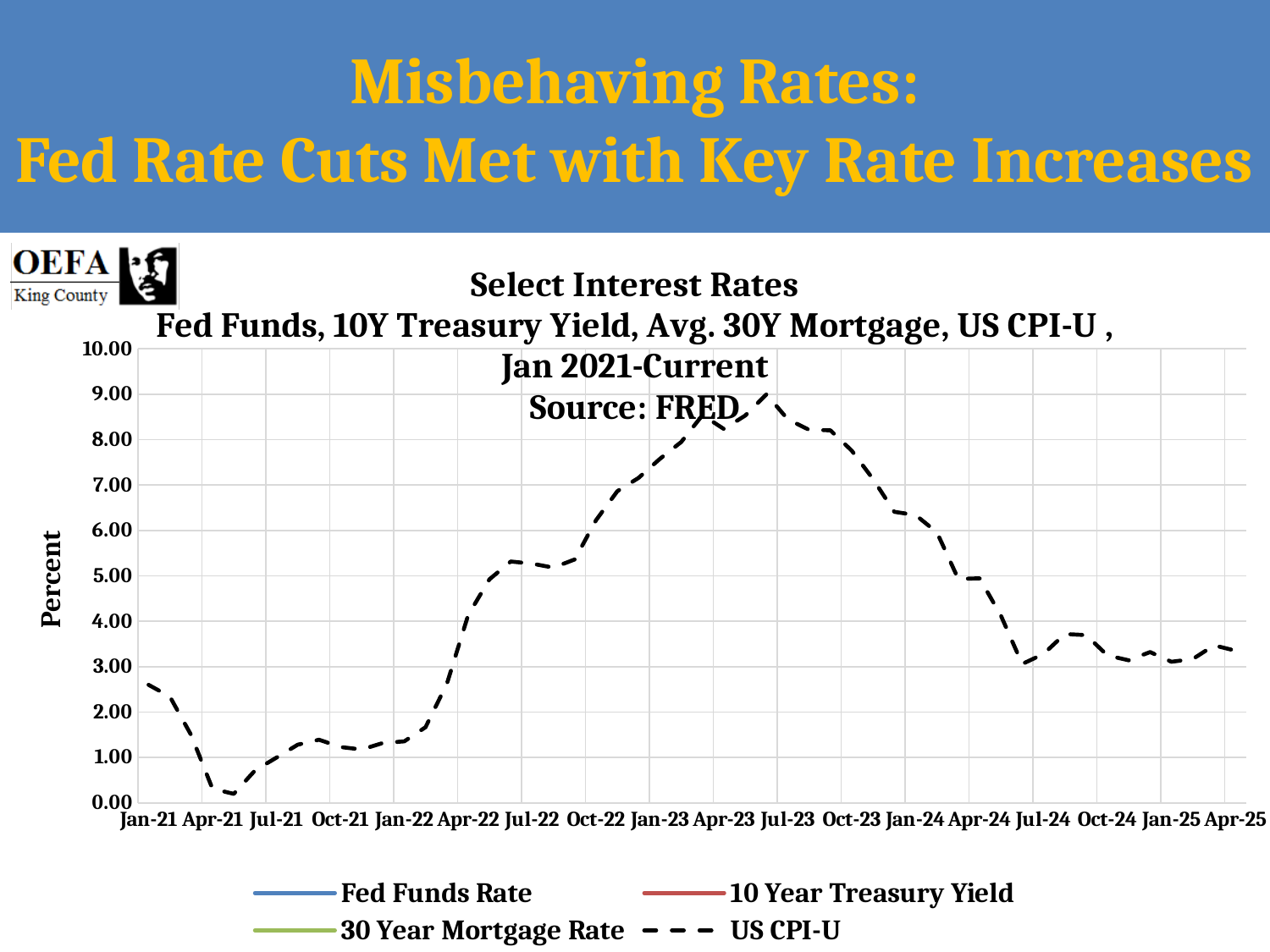
What is the label on the vertical axis? Percent Which is larger for US CPI-U, the value at Jan-21 or the value at Apr-21? Jan-21 Is the US CPI-U value at Jul-24 greater or less than 4.00? less What kind of chart is shown on the slide? line chart According to the chart title, what is the source of the data? FRED How many series does the legend list? 4 Is the peak value of the US CPI-U line greater or less than 8.00? greater Is the US CPI-U value at Apr-21 greater or less than 1.00? less Does the US CPI-U line rise or fall between Jan-22 and Jul-22? rise Does the US CPI-U line rise or fall between Jul-23 and Jul-24? fall